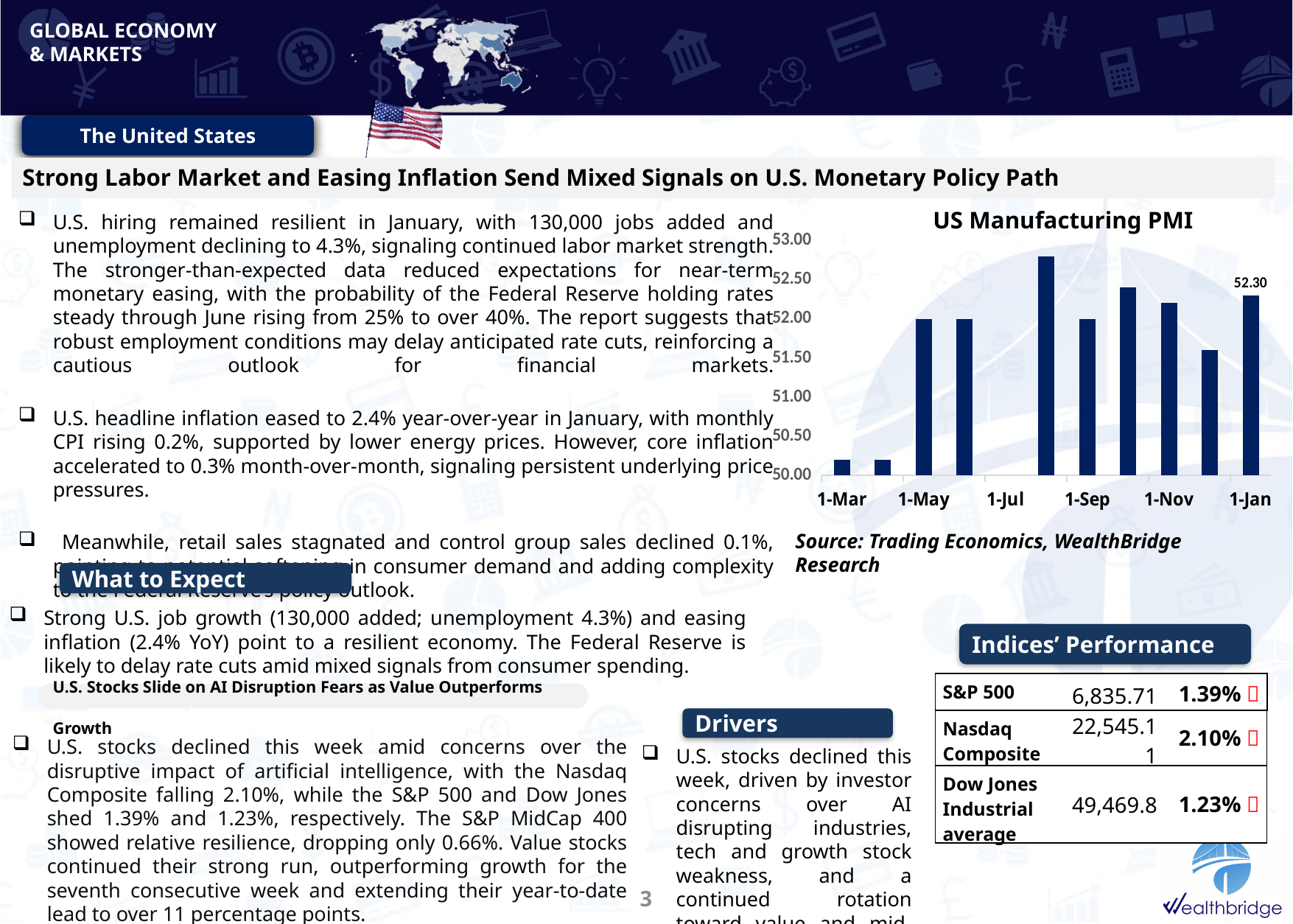
Does the US Manufacturing PMI generally rise or fall from 1-Mar to 1-Jan? rise What is the title of the chart on the slide? US Manufacturing PMI What is the value of the US Manufacturing PMI for 1-Jan? 52.30 How many month labels are shown on the x axis of the US Manufacturing PMI chart? 6 Which has a higher US Manufacturing PMI value, 1-May or 1-Mar? 1-May Is the US Manufacturing PMI value for 1-Nov greater or less than 51.50? greater Which has a higher US Manufacturing PMI value, 1-Mar or 1-Jan? 1-Jan What kind of chart is the US Manufacturing PMI chart? bar chart What is the source cited below the US Manufacturing PMI chart? Trading Economics, WealthBridge Research Is the US Manufacturing PMI value for 1-Mar greater or less than 51.00? less Is the US Manufacturing PMI value for 1-Mar greater or less than 50.50? less